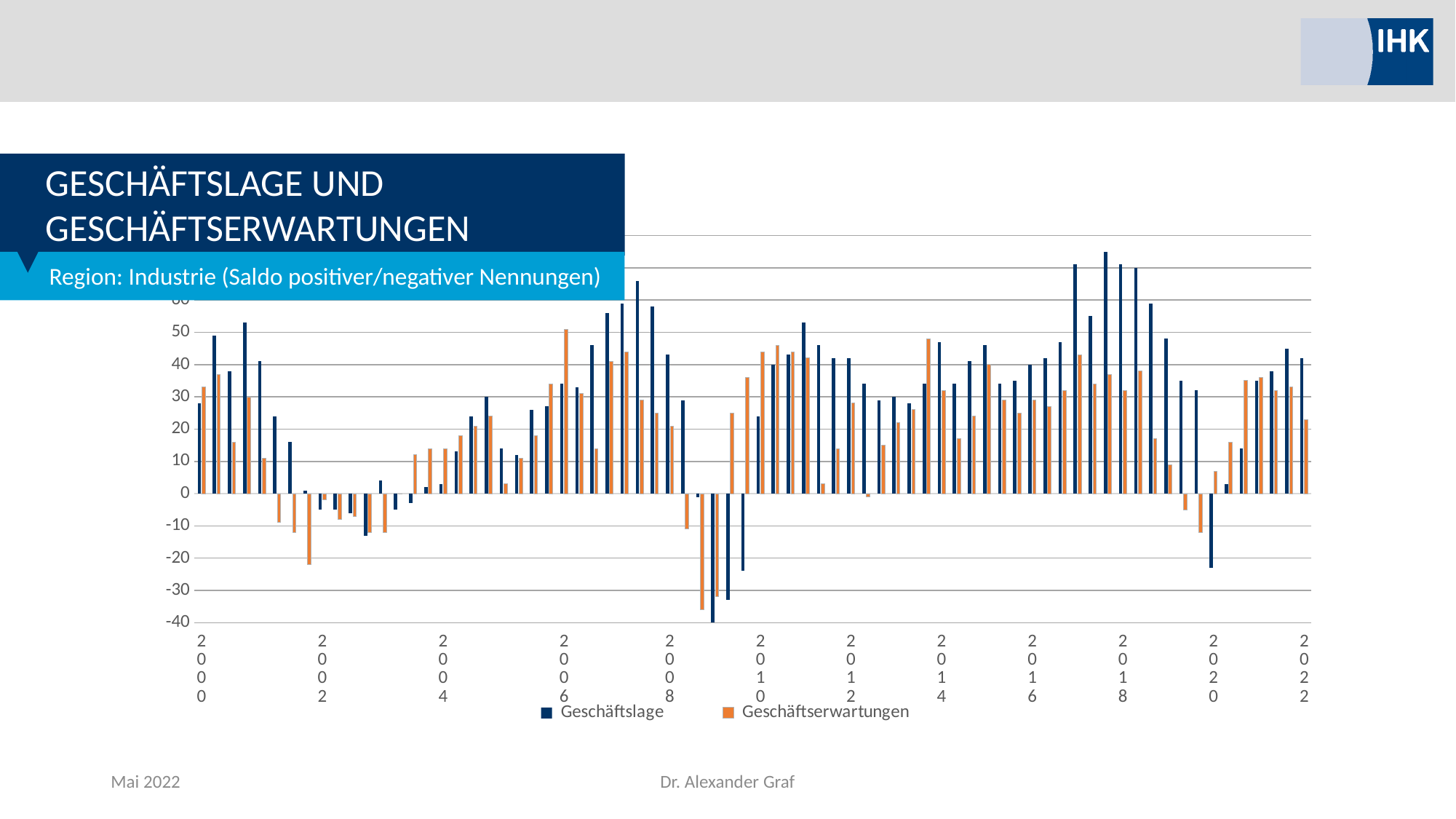
Is the highest Geschäftslage value, around 2018, greater or less than 50? greater How many series does the legend list? 2 Is the Geschäftslage value at the 2020 dip greater or less than -10? less At the last data point (2022), which series has the larger value, Geschäftslage or Geschäftserwartungen? Geschäftslage Is the lowest Geschäftslage value, around 2009, greater or less than -30? less What kind of chart is shown on the slide? bar chart How many year labels are shown on the x axis? 12 Do the Geschäftslage values rise or fall between 2000 and 2002? fall Which colour represents the Geschäftserwartungen series? orange What are the two series named in the legend? Geschäftslage and Geschäftserwartungen Which series reaches the highest value anywhere on the chart? Geschäftslage